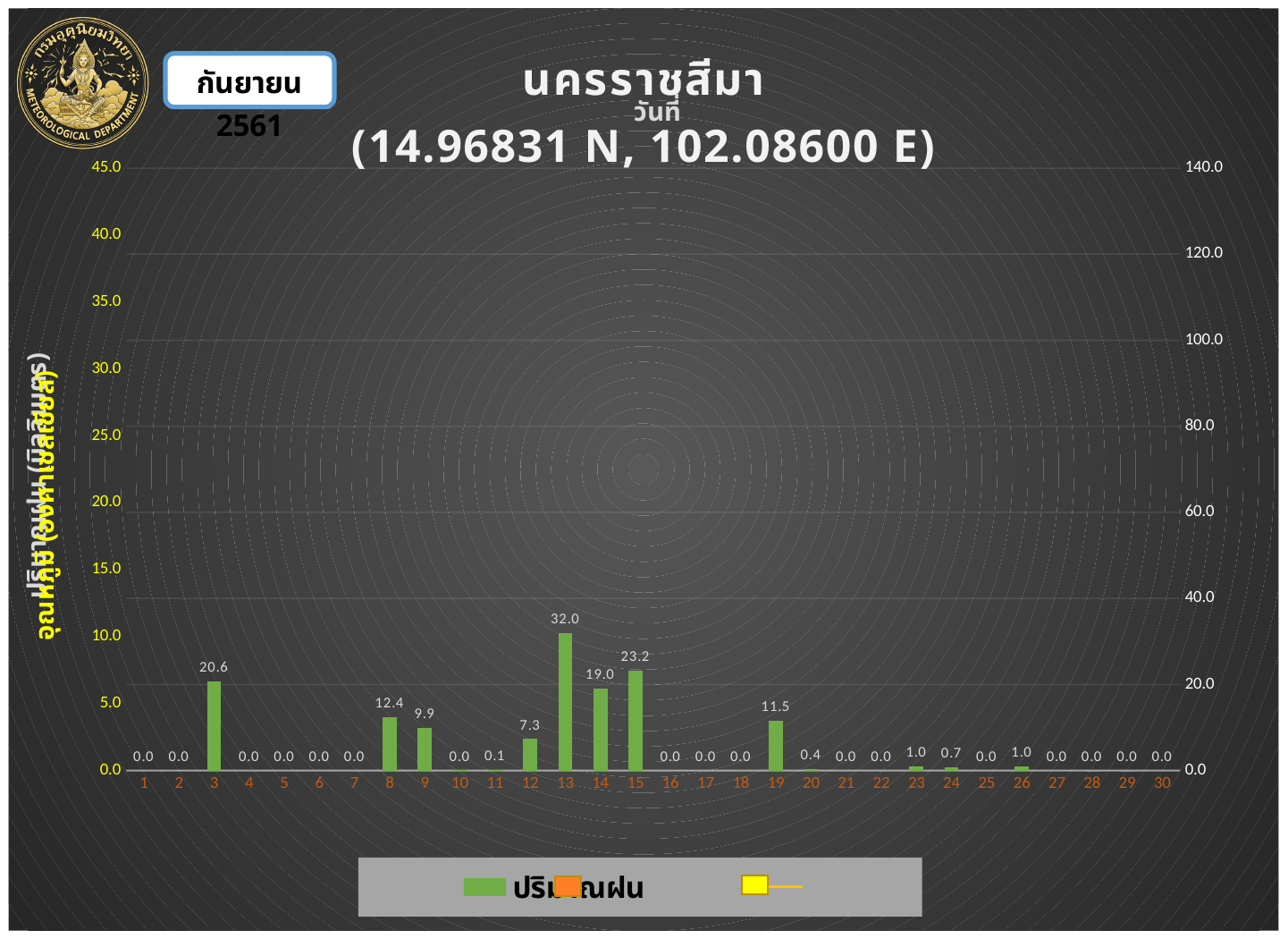
What is the rainfall value shown for day 3? 20.6 Which has the larger rainfall value, day 15 or day 3? day 15 What kind of chart is used to show the rainfall values? bar chart What is the rainfall value shown for day 19? 11.5 What coordinates are given in the chart title? 14.96831 N, 102.08600 E Which day has the highest rainfall value? 13 How many days are shown on the x axis? 30 What is the difference between the rainfall values for day 13 and day 14? 13.0 What is the rainfall value shown for day 15? 23.2 What is the rainfall value shown for day 11? 0.1 What is the difference between the rainfall values for day 8 and day 9? 2.5 What is the rainfall value shown for day 13? 32.0